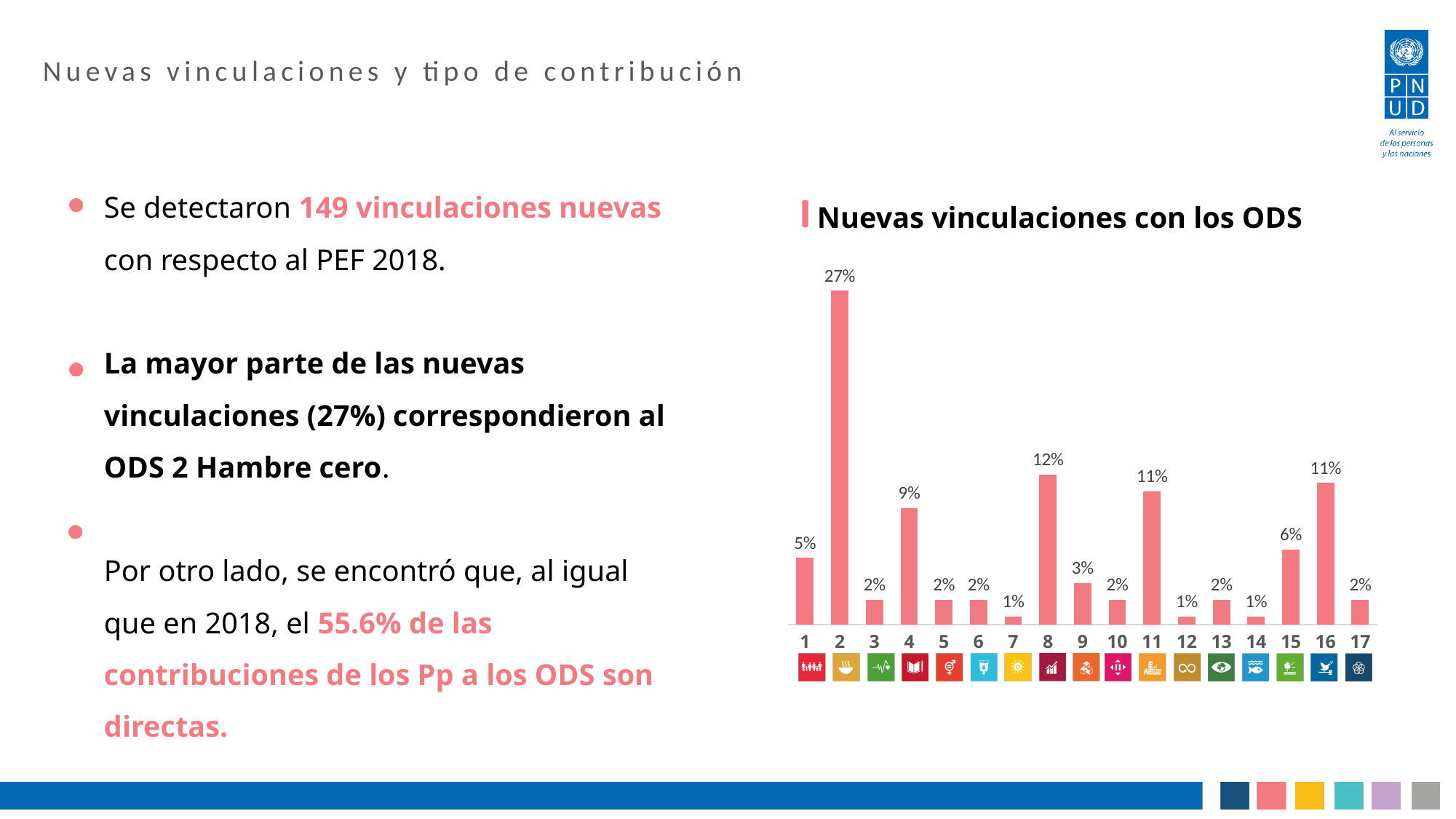
Which ODS has the highest share of new linkages in the chart? 2 What is the value for ODS 2 in the chart? 27% What is the difference between the values for ODS 2 and ODS 8? 15% What is the title of the chart? Nuevas vinculaciones con los ODS What is the value for ODS 4 in the chart? 9% What is the value for ODS 15 in the chart? 6% What is the difference between the values for ODS 11 and ODS 15? 5% What is the value for ODS 8 in the chart? 12% Which has a larger value, ODS 1 or ODS 9? ODS 1 Which has a larger value, ODS 4 or ODS 16? ODS 16 What kind of chart is shown on the slide? Bar chart How many ODS categories are shown on the x axis of the chart? 17